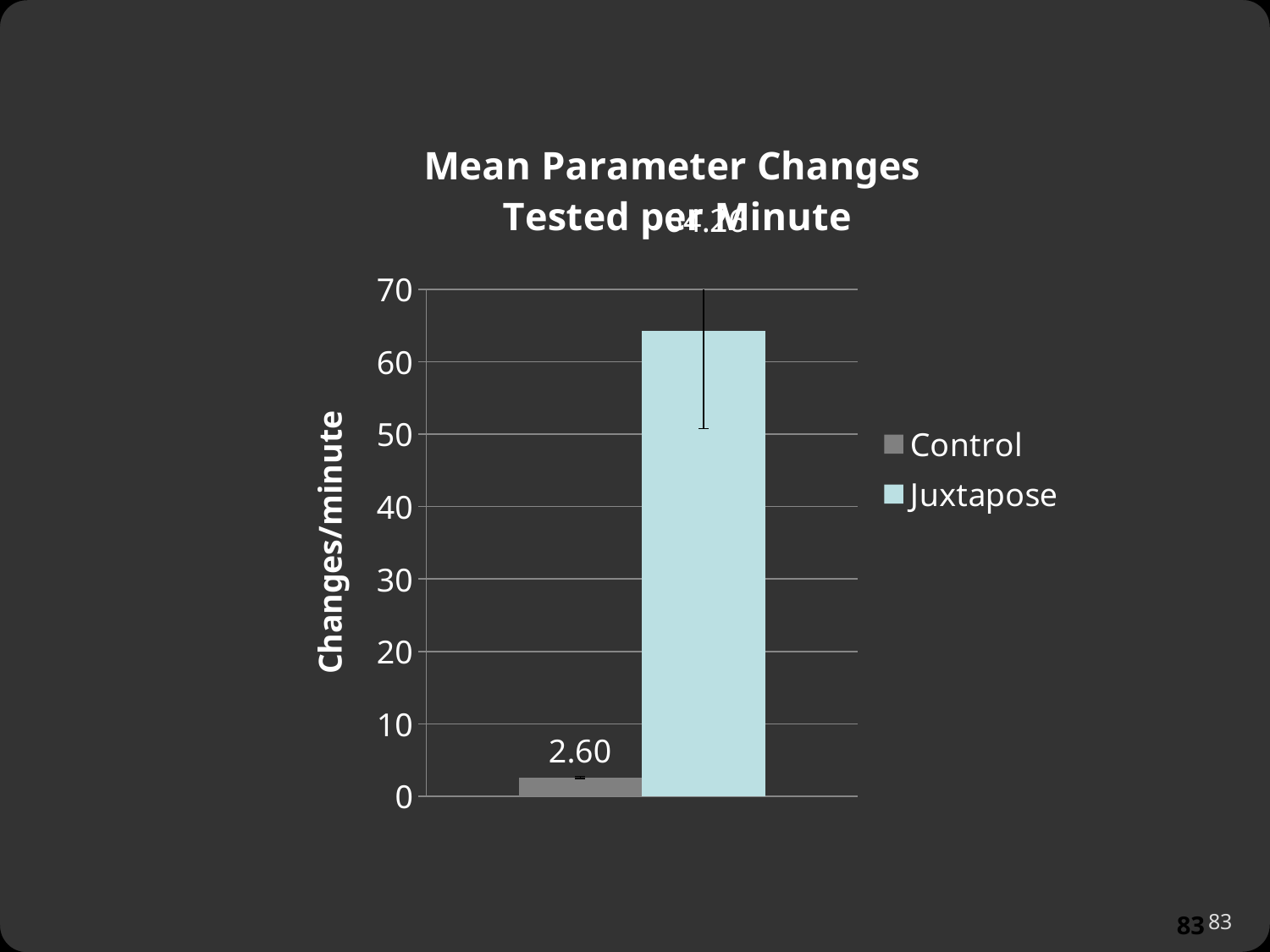
Is the value for Juxtapose greater or less than 60? greater Is the value for Juxtapose greater or less than 70? less What is the value for Control in the chart? 2.60 What is the title of the chart? Mean Parameter Changes Tested per Minute Which is larger, the value for Control or the value for Juxtapose? Juxtapose What kind of chart is shown on the slide? bar chart What is the label on the vertical axis? Changes/minute Is the value for Control greater or less than 10? less How many bars are plotted in the chart? 2 Which series has the highest value? Juxtapose How many series does the legend list? 2 Which series has the lowest value? Control